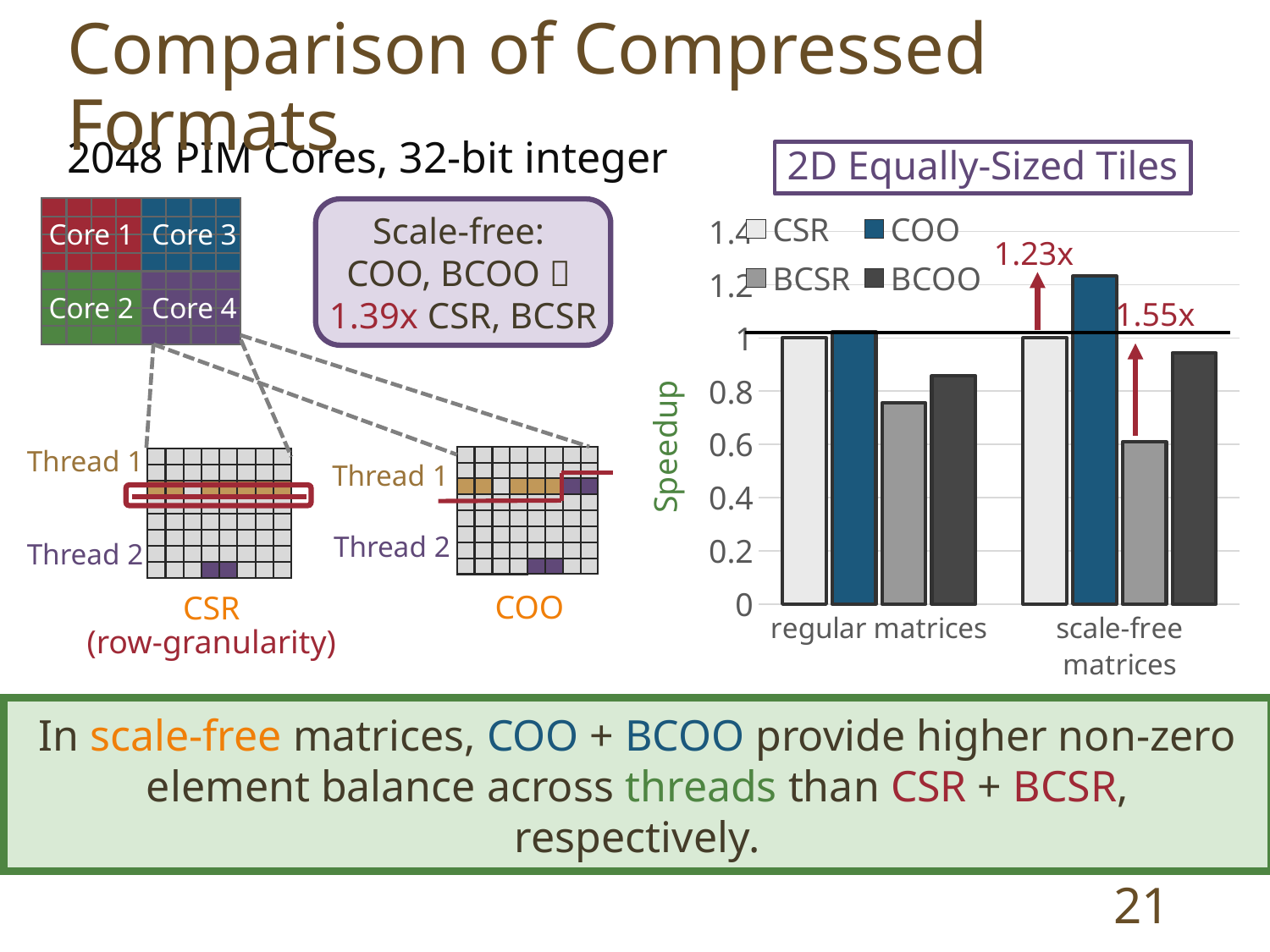
In the "2D Equally-Sized Tiles" chart, is the speedup of COO for scale-free matrices greater or less than 1.2? greater What kind of chart is shown under the title "2D Equally-Sized Tiles"? bar chart What is the label of the y axis in the "2D Equally-Sized Tiles" chart? Speedup How many categories are shown on the x axis of the "2D Equally-Sized Tiles" chart? 2 In the "2D Equally-Sized Tiles" chart, which series has the lowest speedup for scale-free matrices? BCSR In the "2D Equally-Sized Tiles" chart, which is larger for scale-free matrices: the speedup of COO or of BCOO? COO In the "2D Equally-Sized Tiles" chart, is the BCSR speedup larger for regular matrices or for scale-free matrices? regular matrices In the "2D Equally-Sized Tiles" chart, is the speedup of BCOO for scale-free matrices greater or less than 1? less In the "2D Equally-Sized Tiles" chart, which series has the lowest speedup for regular matrices? BCSR In the "2D Equally-Sized Tiles" chart, is the speedup of BCSR for regular matrices greater or less than 0.8? less In the "2D Equally-Sized Tiles" chart, which series has the highest speedup for scale-free matrices? COO How many series does the legend of the "2D Equally-Sized Tiles" chart list? 4